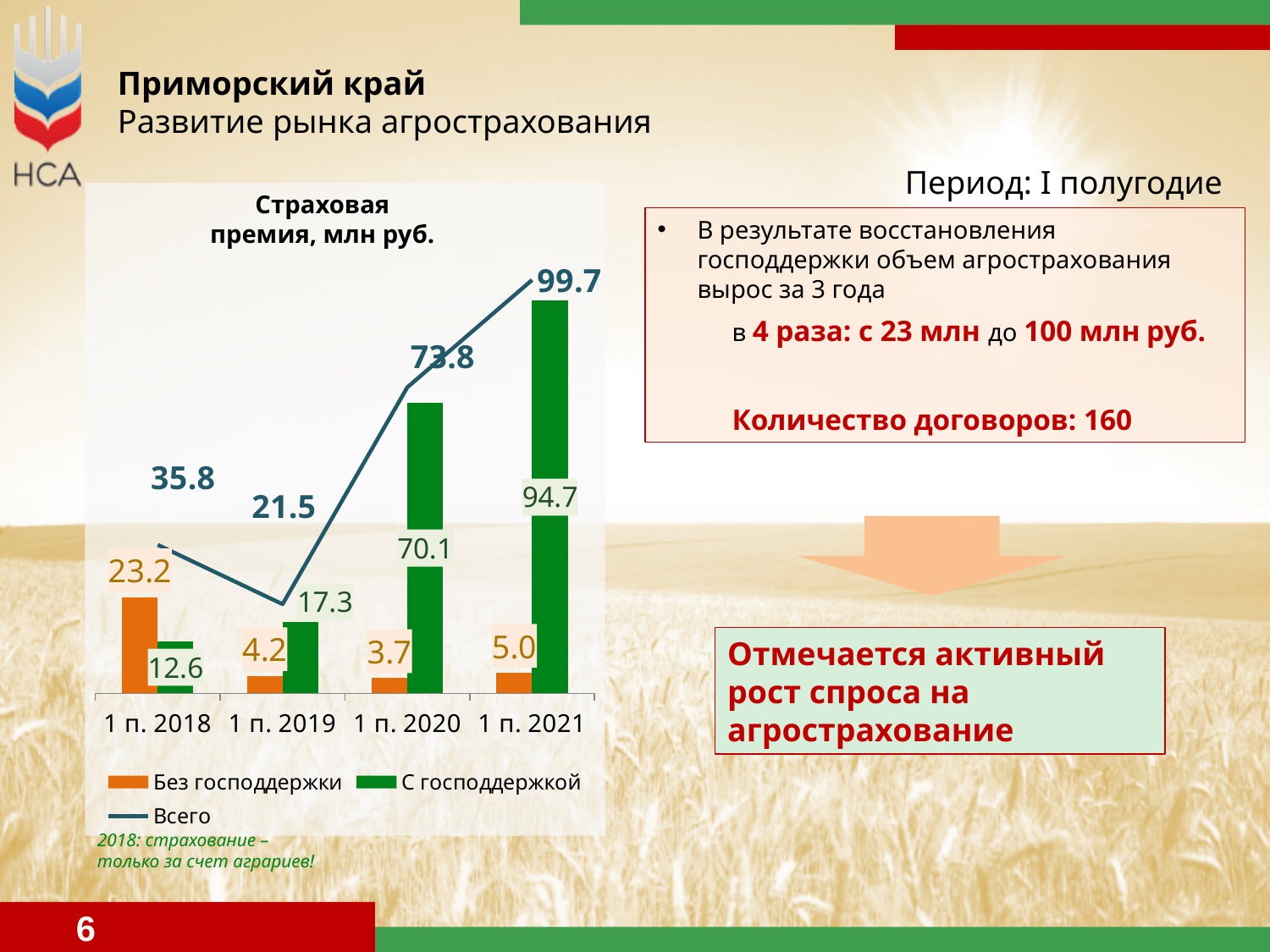
How many series does the legend list? 3 What is the value of 'С господдержкой' for 1 п. 2019? 17.3 What kind of chart is used for the 'Без господдержки' and 'С господдержкой' series? Bar chart In which period is the 'Всего' line at its lowest? 1 п. 2019 What is the title of the chart? Страховая премия, млн руб. What is the value of 'С господдержкой' for 1 п. 2020? 70.1 What is the value of the 'Всего' line for 1 п. 2021? 99.7 What is the value of 'Без господдержки' for 1 п. 2018? 23.2 What is the difference between the 'Всего' values for 1 п. 2021 and 1 п. 2020? 25.9 In which period is 'Без господдержки' the highest? 1 п. 2018 How many periods are shown on the x axis? 4 Which is larger for 1 п. 2018: 'Без господдержки' or 'С господдержкой'? Без господдержки